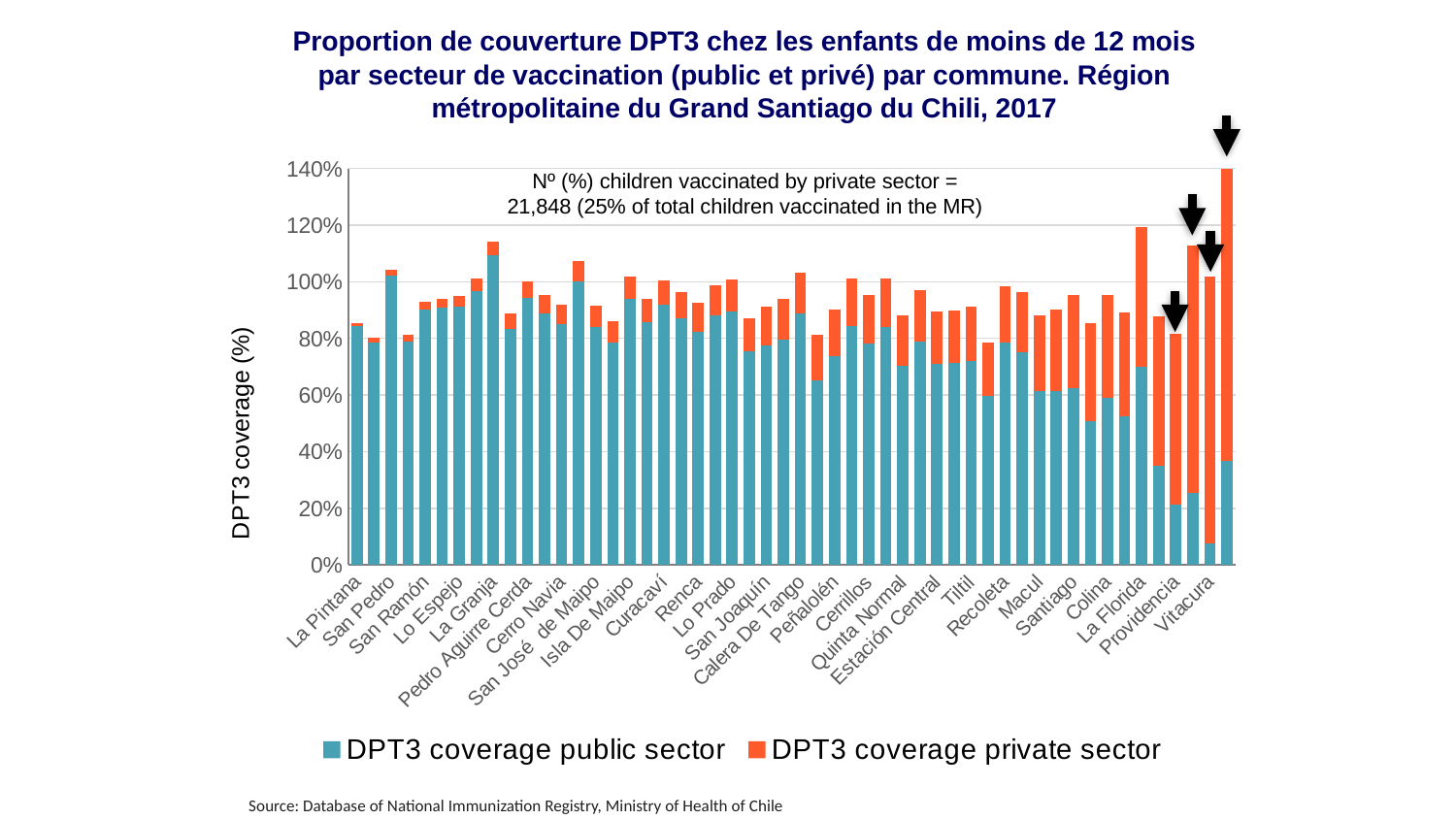
Is the total DPT3 coverage for Colina greater or less than 100%? less Is the total DPT3 coverage for Santiago greater or less than 100%? less What kind of chart is shown on the slide? Stacked bar chart Is the total DPT3 coverage for Tiltil greater or less than 100%? less How many series does the legend list? 2 What are the two series named in the legend? DPT3 coverage public sector; DPT3 coverage private sector According to the annotation on the chart, how many children were vaccinated by the private sector? 21,848 (25% of total children vaccinated in the MR)